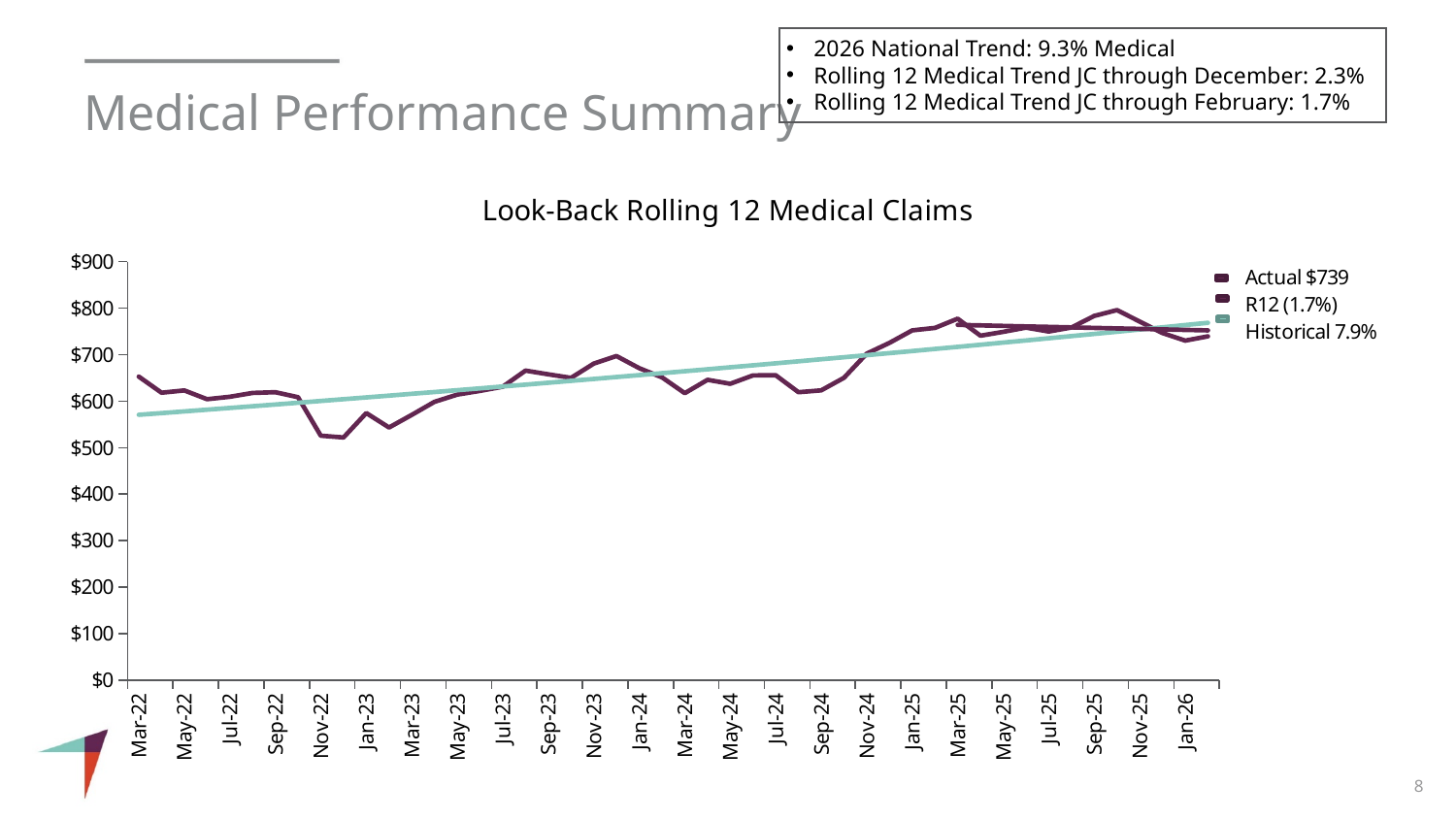
How many entries does the chart legend list? 3 Is the Actual value for Sep-24 greater or less than $700? less How many month labels are shown on the x axis? 24 What value does the legend show for the Actual series? $739 What type of chart is shown on the slide? line chart Is the Actual value for Mar-22 greater or less than $600? greater Is the Actual value for Jan-26 greater or less than $700? greater Overall, do the Actual values rise or fall from Mar-22 to Jan-26? rise What is the title of the chart? Look-Back Rolling 12 Medical Claims Which is larger, the Actual value for Mar-22 or for Nov-22? Mar-22